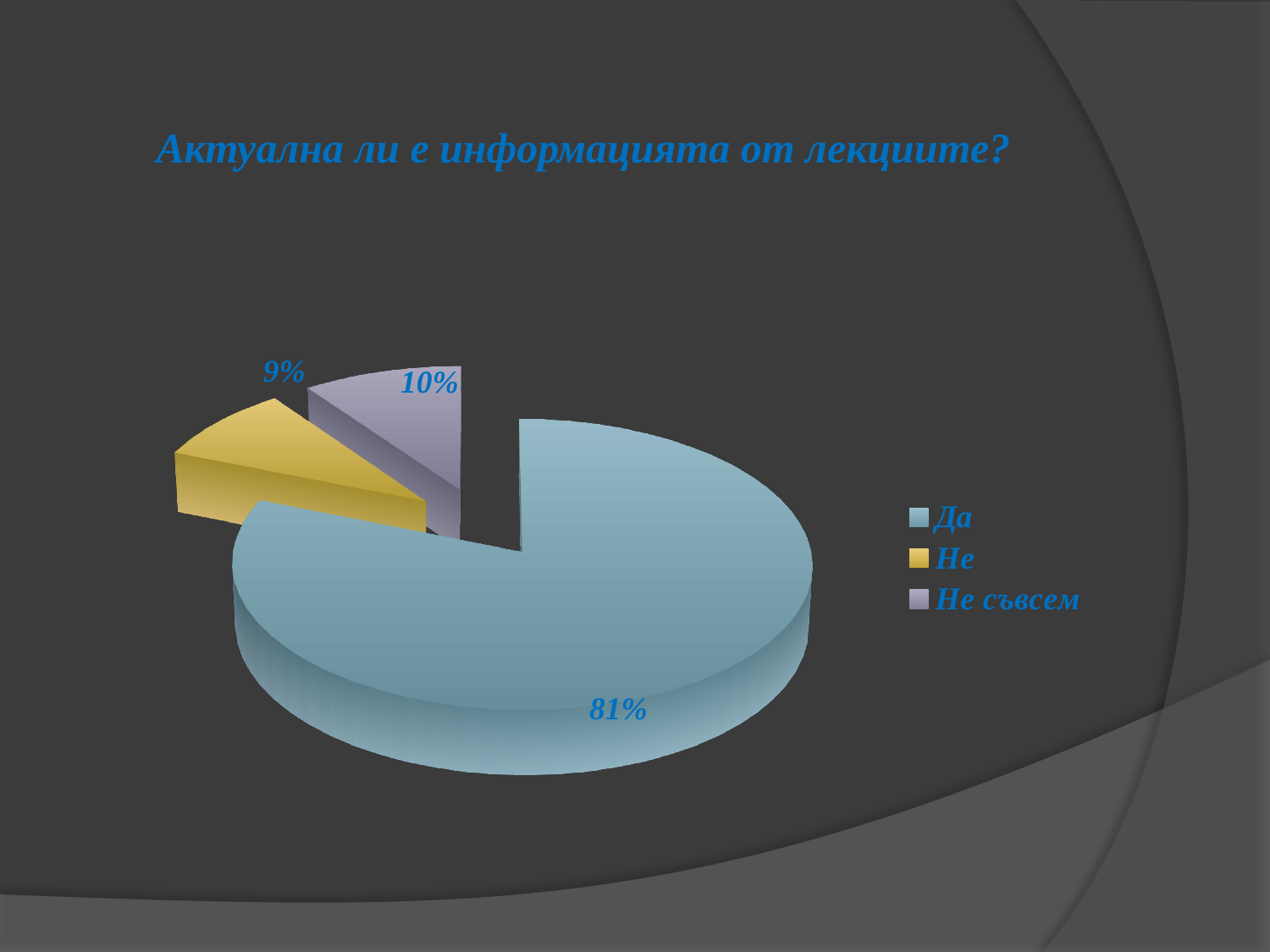
What is the difference in percentage points between "Да" and "Не съвсем"? 71 What share of the pie does "Не съвсем" represent? 10% How many categories does the pie chart show? 3 What is the title of the chart? Актуална ли е информацията от лекциите? What kind of chart is shown on the slide? Pie chart What share of the pie does "Не" represent? 9% What colour is the slice for "Не"? Yellow What is the difference in percentage points between "Не съвсем" and "Не"? 1 What share of the pie does "Да" represent? 81% Which category has the largest slice of the pie? Да Which is larger, the share for "Не" or the share for "Не съвсем"? Не съвсем Which category has the smallest slice of the pie? Не